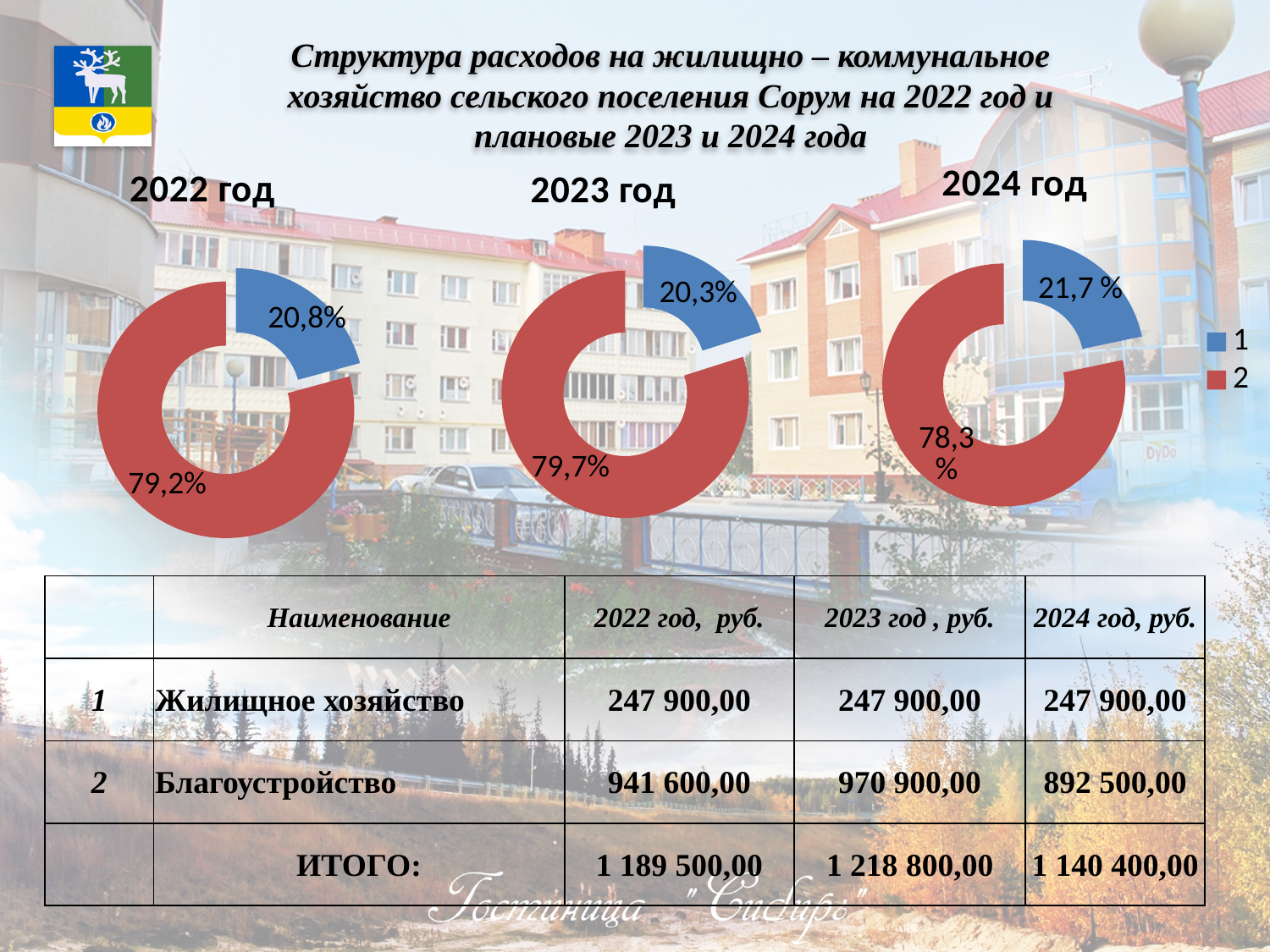
How many slices does the 2023 год chart have? 2 Which colour represents legend entry 2 in the charts? red In the 2022 год chart, what share is shown for the blue slice (series 1)? 20,8% In the 2024 год chart, which slice is larger, the blue one (1) or the red one (2)? the red one (2) In the 2024 год chart, what share is shown for the red slice (series 2)? 78,3 % How many entries does the legend on the right list? 2 In the 2023 год chart, what share is shown for the blue slice (series 1)? 20,3% In the 2023 год chart, what share is shown for the red slice (series 2)? 79,7% What kind of chart is used for the 2022 год chart? doughnut chart In the 2024 год chart, what share is shown for the blue slice (series 1)? 21,7 % In the 2022 год chart, what share is shown for the red slice (series 2)? 79,2% How many doughnut charts are shown on the slide? 3